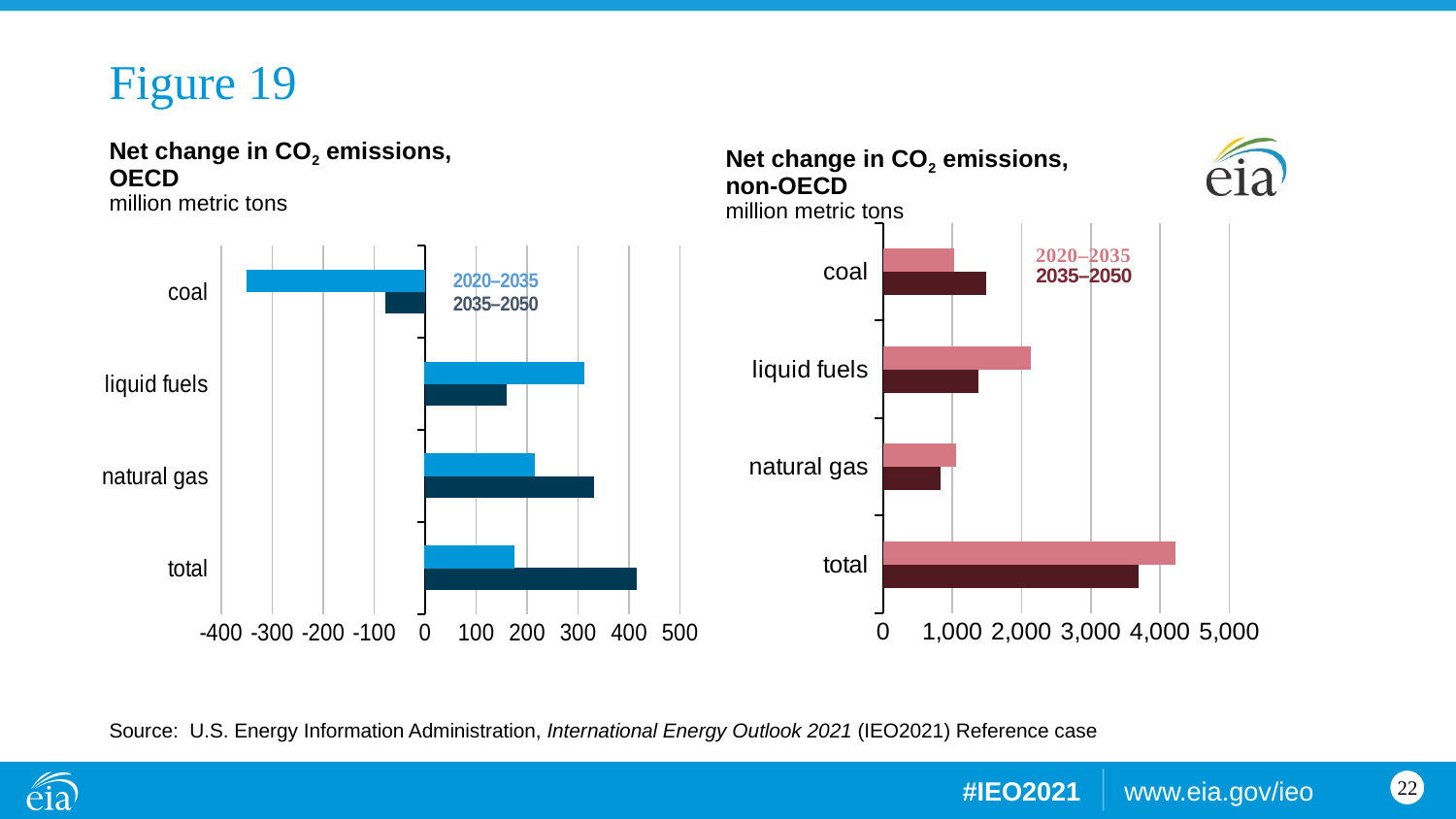
On the 'Net change in CO2 emissions, non-OECD' chart, is the 2020–2035 value for total greater or less than 4,000? greater What kind of chart is the 'Net change in CO2 emissions, OECD' chart? bar chart On the 'Net change in CO2 emissions, OECD' chart, is the 2020–2035 value for coal greater or less than -300? less What unit of measurement is stated under the titles of both charts? million metric tons On the 'Net change in CO2 emissions, OECD' chart, which category has the lowest 2020–2035 value? coal On the 'Net change in CO2 emissions, OECD' chart, is the 2035–2050 value for total greater or less than 300? greater On the 'Net change in CO2 emissions, OECD' chart, which period has the larger value for natural gas, 2020–2035 or 2035–2050? 2035–2050 On the 'Net change in CO2 emissions, non-OECD' chart, which category has the highest 2020–2035 value? total How many categories are shown on the 'Net change in CO2 emissions, non-OECD' chart? 4 On the 'Net change in CO2 emissions, non-OECD' chart, which period has the larger value for liquid fuels, 2020–2035 or 2035–2050? 2020–2035 How many series does the legend list on the 'Net change in CO2 emissions, OECD' chart? 2